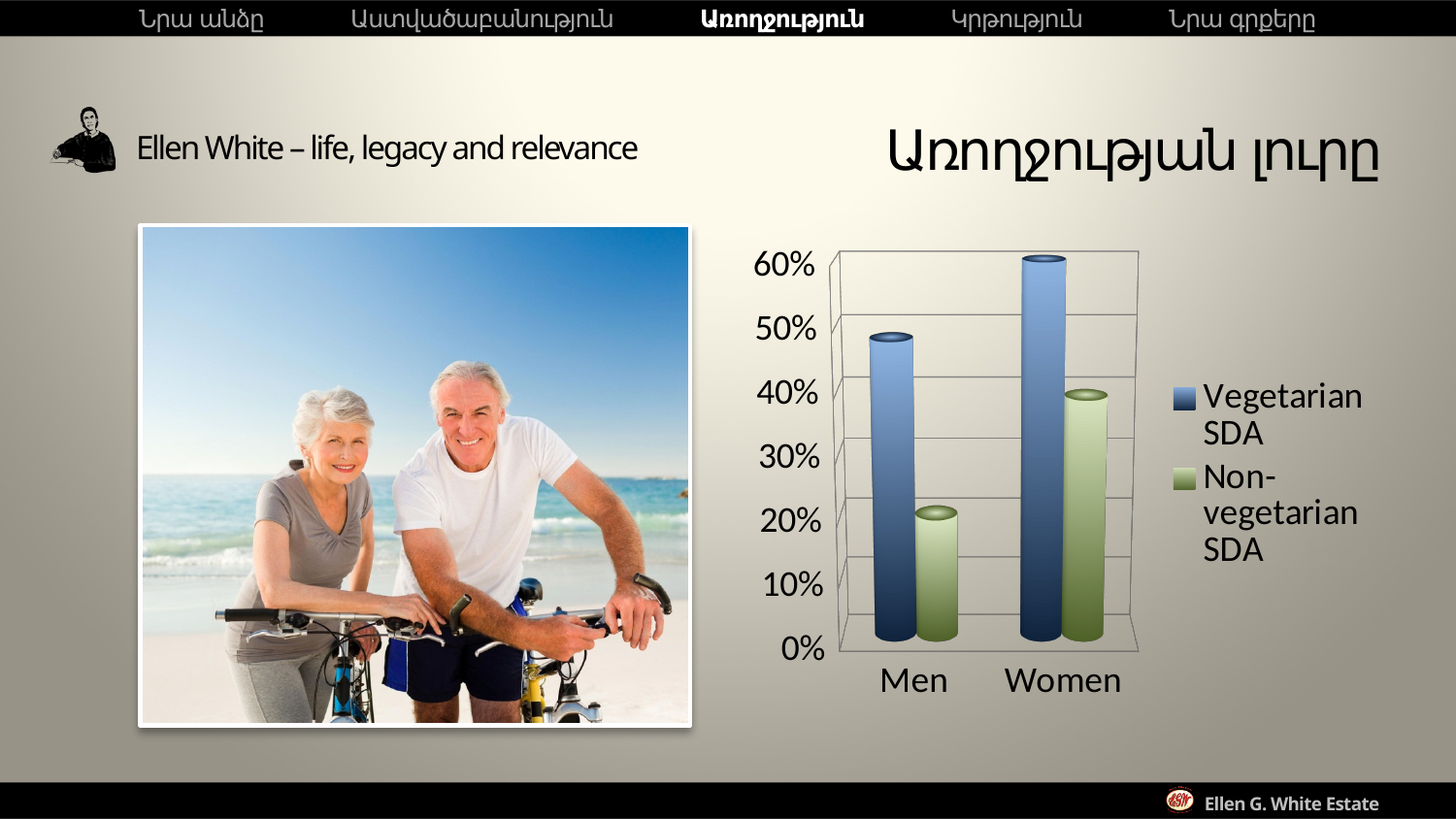
Is the Vegetarian SDA value for Women greater or less than 50%? greater Which category and series combination has the highest bar in the chart? Women, Vegetarian SDA Does the Non-vegetarian SDA series rise or fall from Men to Women? rise How many categories are shown on the x axis of the chart? 2 Which category and series combination has the lowest bar in the chart? Men, Non-vegetarian SDA What kind of chart is shown on the slide? bar chart Is the Vegetarian SDA value for Men greater or less than 40%? greater Is the Non-vegetarian SDA value for Women greater or less than 30%? greater Which series are listed in the chart's legend? Vegetarian SDA and Non-vegetarian SDA How many series does the chart's legend list? 2 Which is larger: the Vegetarian SDA value for Men or the Vegetarian SDA value for Women? Women